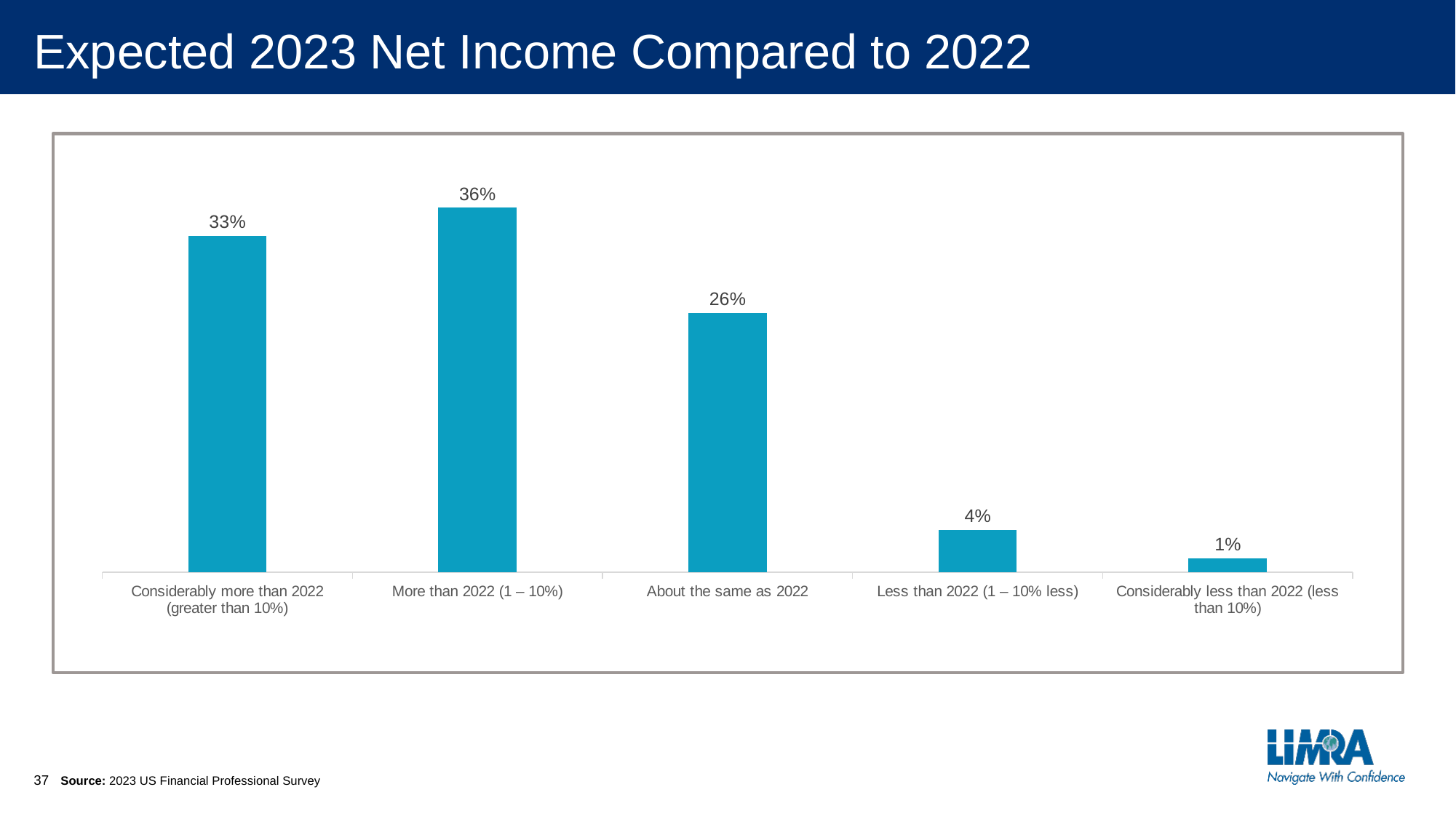
Which is larger: the value for "Considerably more than 2022 (greater than 10%)" or "About the same as 2022"? Considerably more than 2022 (greater than 10%) What is the value for "More than 2022 (1 – 10%)"? 36% What is the value for "Considerably less than 2022 (less than 10%)"? 1% What is the difference between the values for "More than 2022 (1 – 10%)" and "About the same as 2022"? 10% What is the title of the slide? Expected 2023 Net Income Compared to 2022 What percentage of respondents expect 2023 net income to be considerably more than 2022 (greater than 10%)? 33% How many categories are shown in the chart? 5 Which category has the highest value? More than 2022 (1 – 10%) What percentage expect net income to be about the same as 2022? 26% What is the value for "Less than 2022 (1 – 10% less)"? 4% Which category has the lowest value? Considerably less than 2022 (less than 10%) What type of chart is shown on the slide? Bar chart